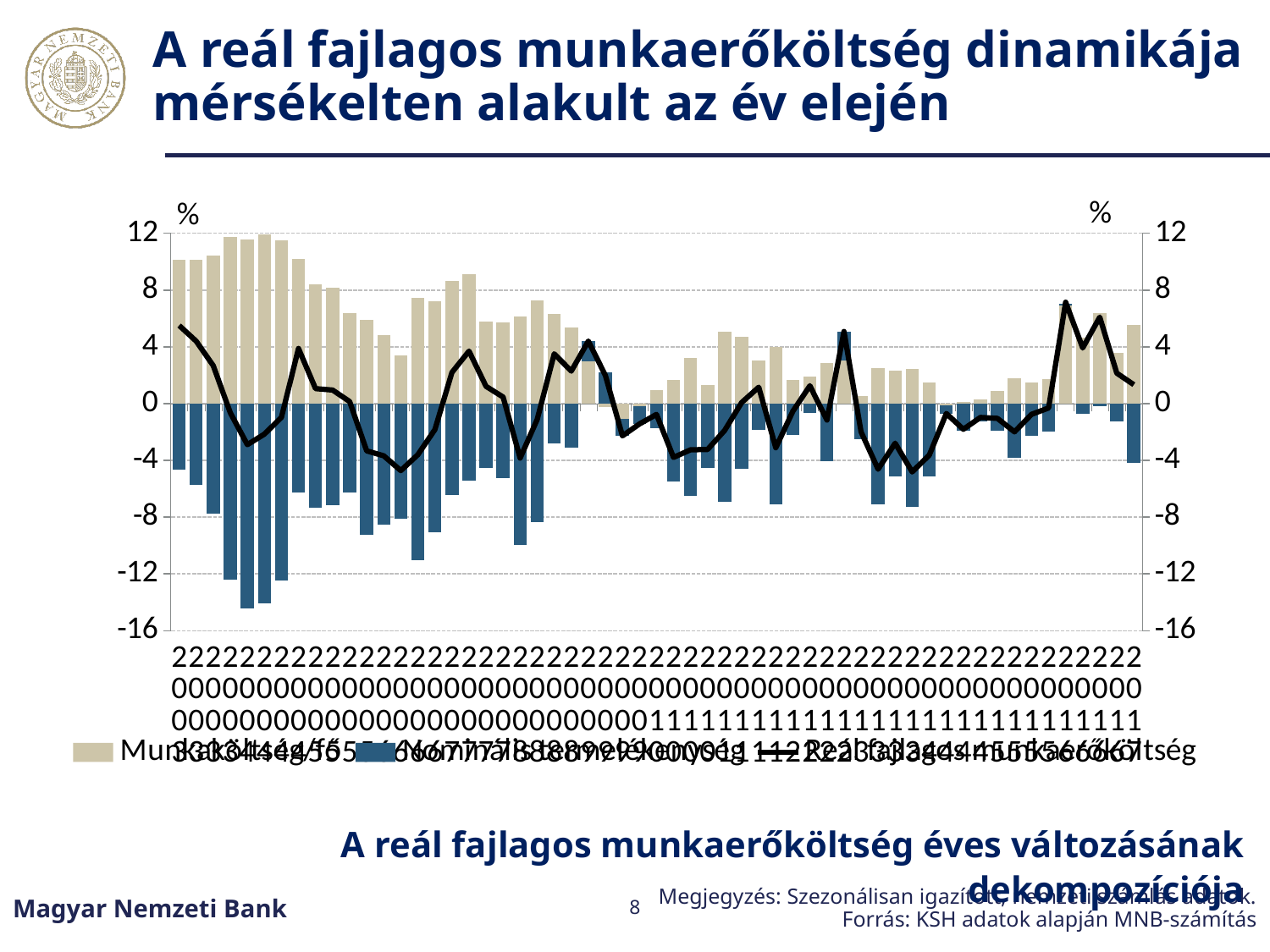
How many series does the chart's legend list? 3 What is the title of the chart on the slide? A reál fajlagos munkaerőköltség éves változásának dekompozíciója Is the value of the lowest blue bar greater or less than -12? less What is the highest tick value shown on the left vertical axis? 12 What is the lowest tick value shown on the left vertical axis? -16 Is the final point of the black line greater or less than 0? greater What kind of chart is shown on the slide? A bar chart with a line Do the beige bars generally rise or fall from the left edge of the chart to the middle of the chart? fall Is the value of the tallest beige bar greater or less than 8? greater